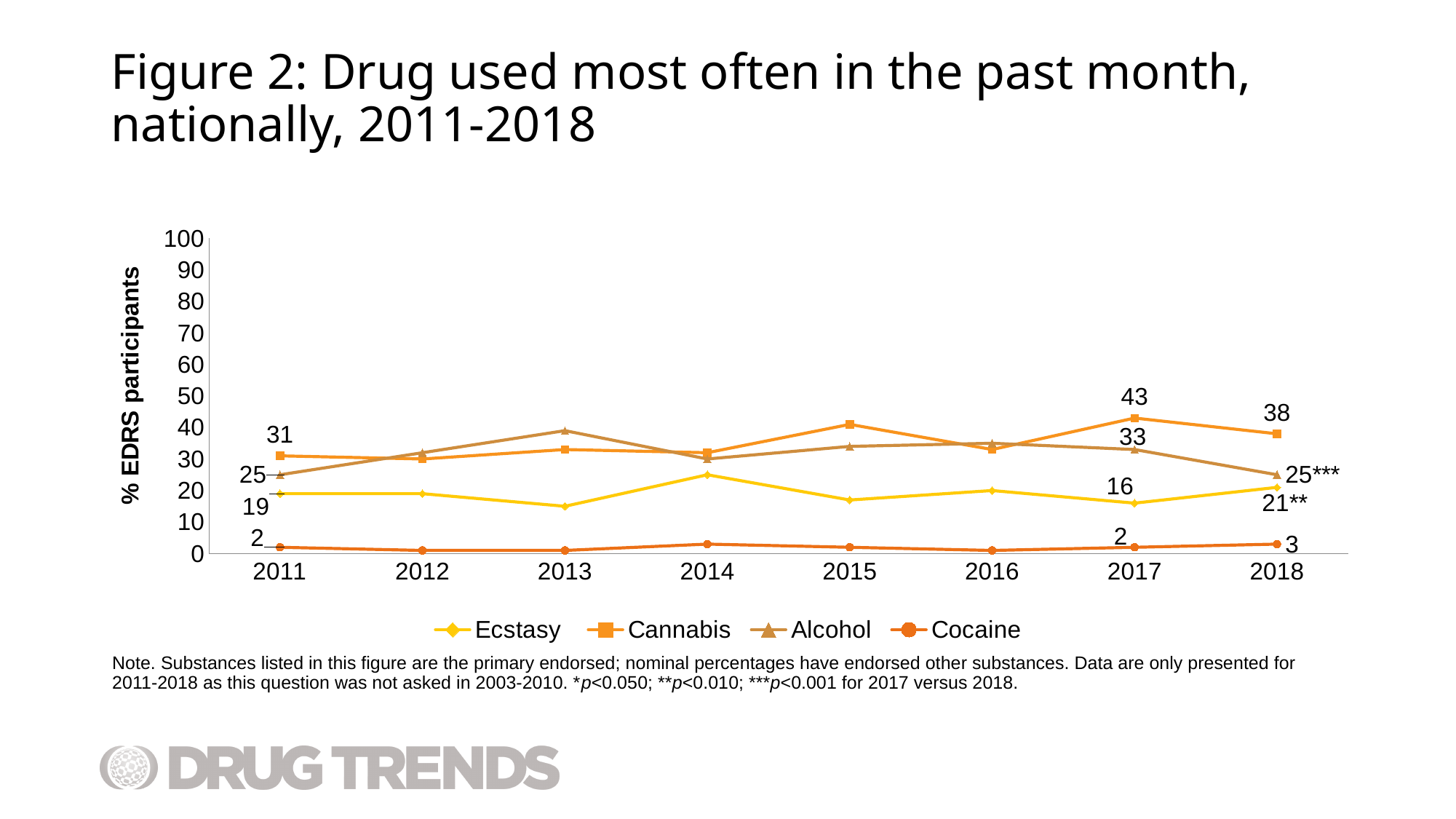
What is the label on the y axis? % EDRS participants How many series does the legend list? 4 Which series had the higher value in 2017, Cannabis or Alcohol? Cannabis What is the value for Cocaine in 2018? 3 What is the value for Ecstasy in 2017? 16 Which series had the lowest value in 2011? Cocaine What kind of chart is shown on the slide? line chart What is the value for Alcohol in 2011? 25 What is the value for Cannabis in 2017? 43 By how much did the Cannabis value fall from 2017 to 2018? 5 How many years are shown on the x axis? 8 Is the value for Alcohol in 2013 greater or less than 30? greater